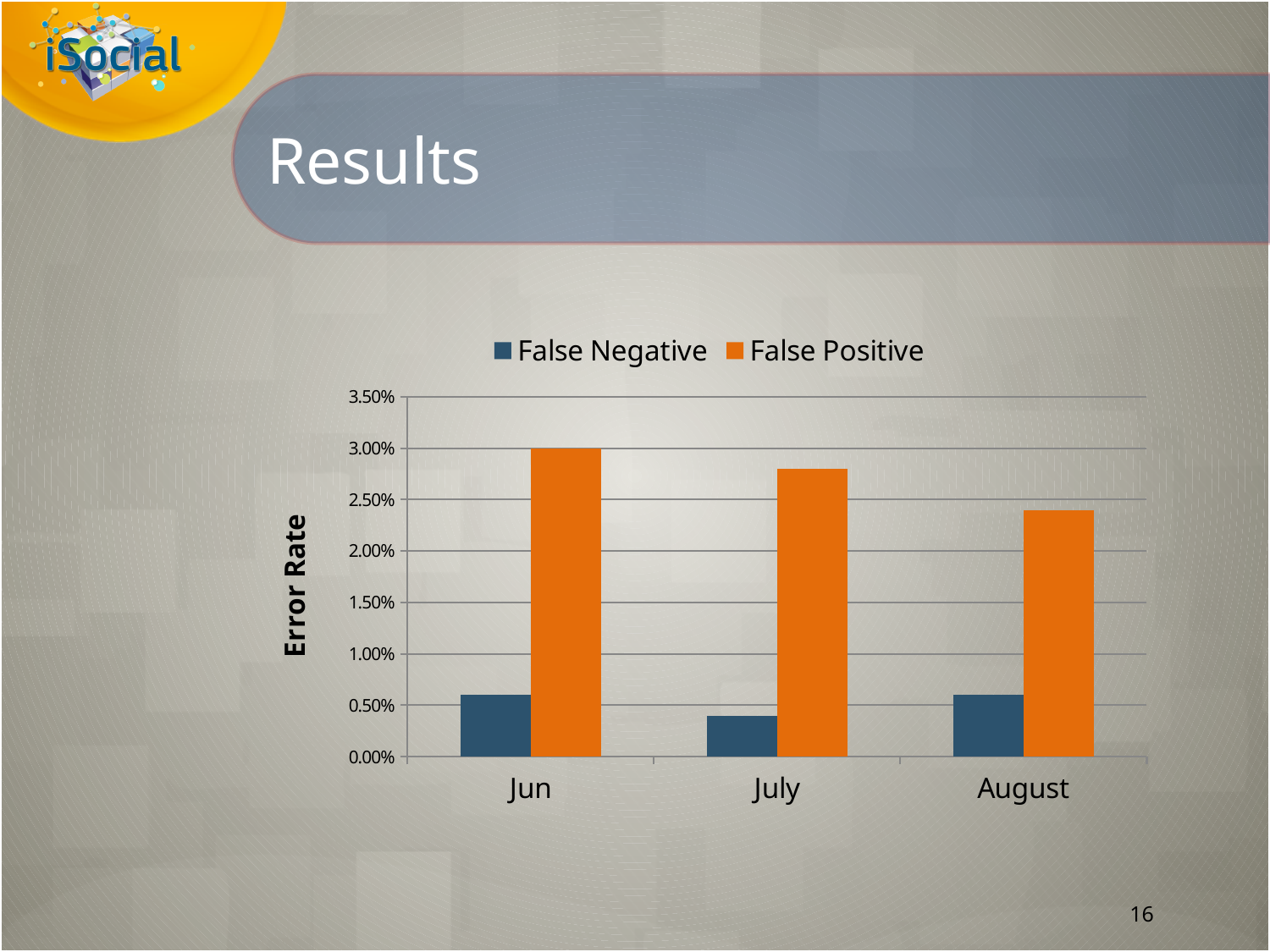
Is the False Negative error rate for Jun greater or less than 1.00%? less In which month is the False Positive error rate lowest? August What is the label on the vertical axis? Error Rate Which is larger, the False Positive error rate for Jun or for August? Jun In which month is the False Positive error rate highest? Jun How many series does the legend list? 2 How many months are shown on the x axis? 3 Does the False Positive error rate rise or fall from Jun to August? fall What is the False Positive error rate for Jun? 3.00% Is the False Positive error rate for July greater or less than 2.50%? greater What kind of chart is shown on the slide? bar chart In which month is the False Negative error rate lowest? July